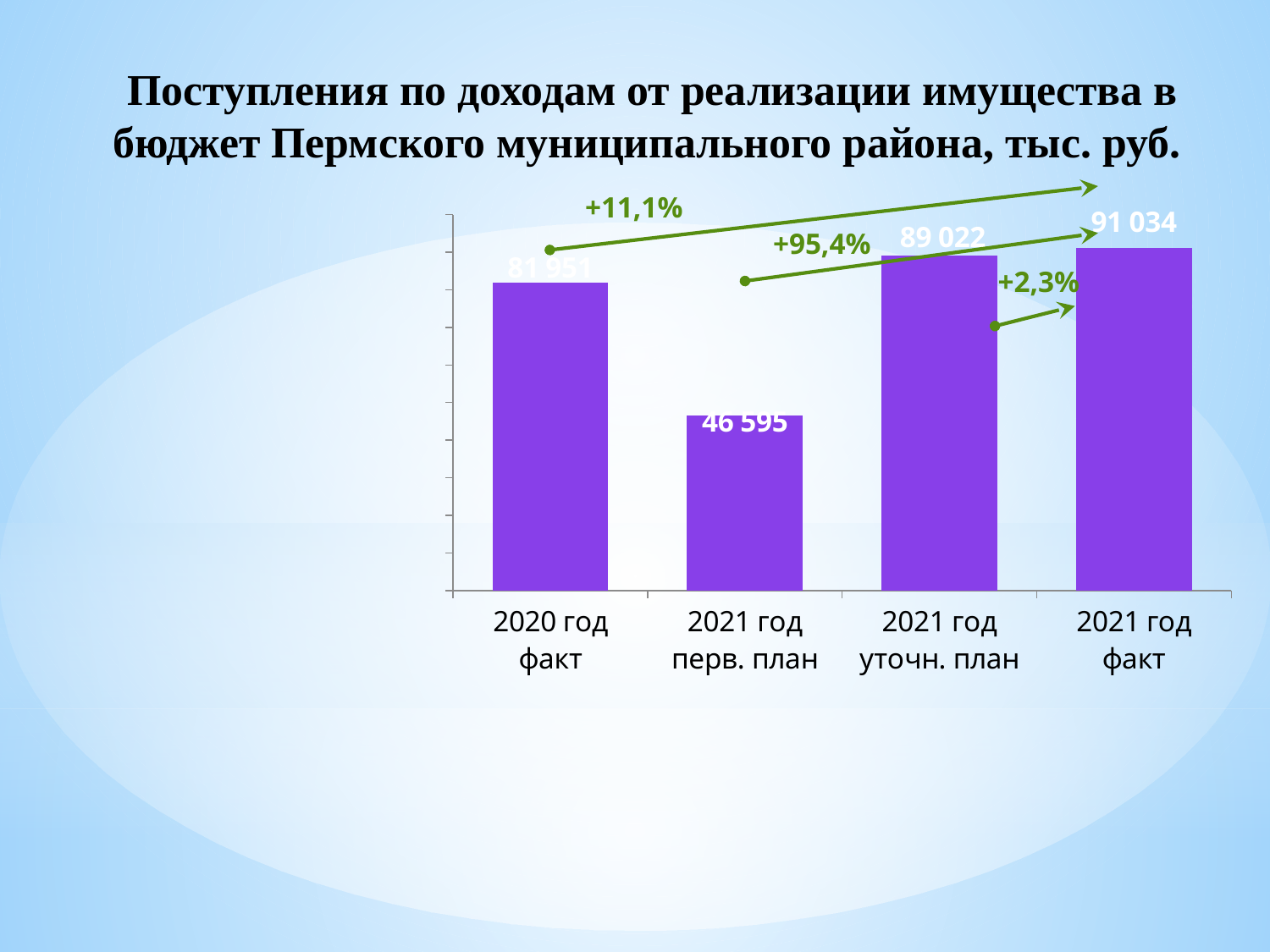
What is the value for 2021 год перв. план? 46 595 What is the value for 2021 год уточн. план? 89 022 Which category has the highest value? 2021 год факт What is the value for 2021 год факт? 91 034 Which category has the lowest value? 2021 год перв. план How many bars are shown in the chart? 4 Which is larger, the value for 2020 год факт or the value for 2021 год уточн. план? 2021 год уточн. план What is the difference between the values for 2020 год факт and 2021 год перв. план? 35 356 What is the value for 2020 год факт? 81 951 What percentage change is annotated between 2021 год перв. план and 2021 год факт? +95,4% What is the difference between the values for 2021 год факт and 2021 год уточн. план? 2 012 What kind of chart is shown on the slide? bar chart